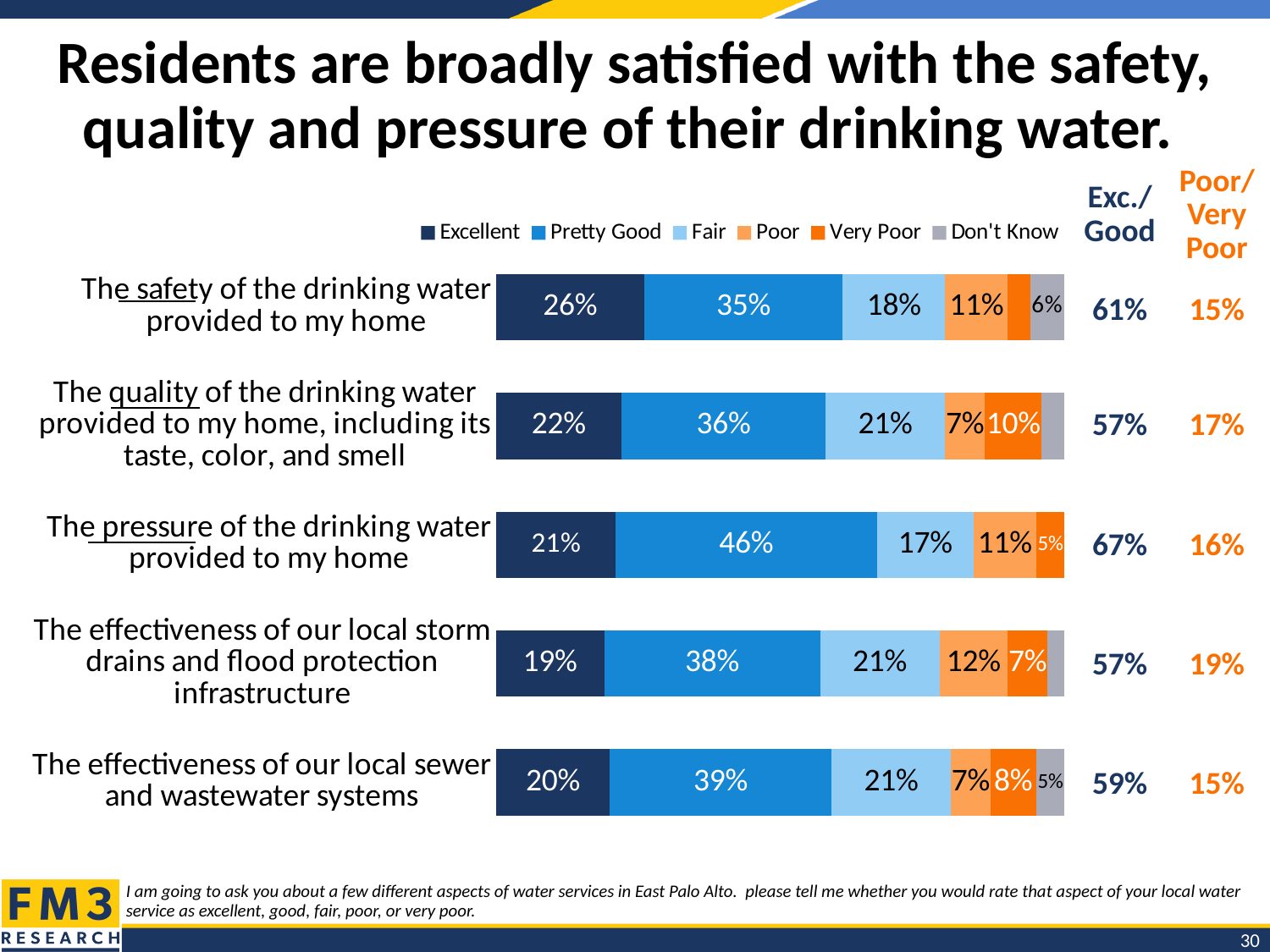
Which legend entry is shown in the darkest blue colour? Excellent How many series does the legend list? 6 How many items (bars) are shown in the chart? 5 What percentage rated the pressure of the drinking water provided to their home as Pretty Good? 46% How much higher is the Pretty Good percentage for water pressure than for water safety? 11% What is the combined Exc./Good percentage shown for the effectiveness of local sewer and wastewater systems? 59% What type of chart is shown on the slide? Stacked bar chart What percentage of residents rated the safety of the drinking water provided to their home as Excellent? 26% Which item has the highest Excellent percentage? The safety of the drinking water provided to my home What is the Fair percentage for the effectiveness of local storm drains and flood protection infrastructure? 21% Which item has the lowest Excellent percentage? The effectiveness of our local storm drains and flood protection infrastructure Which has a larger Poor/Very Poor percentage: the quality of the drinking water or the effectiveness of local storm drains? The effectiveness of our local storm drains and flood protection infrastructure